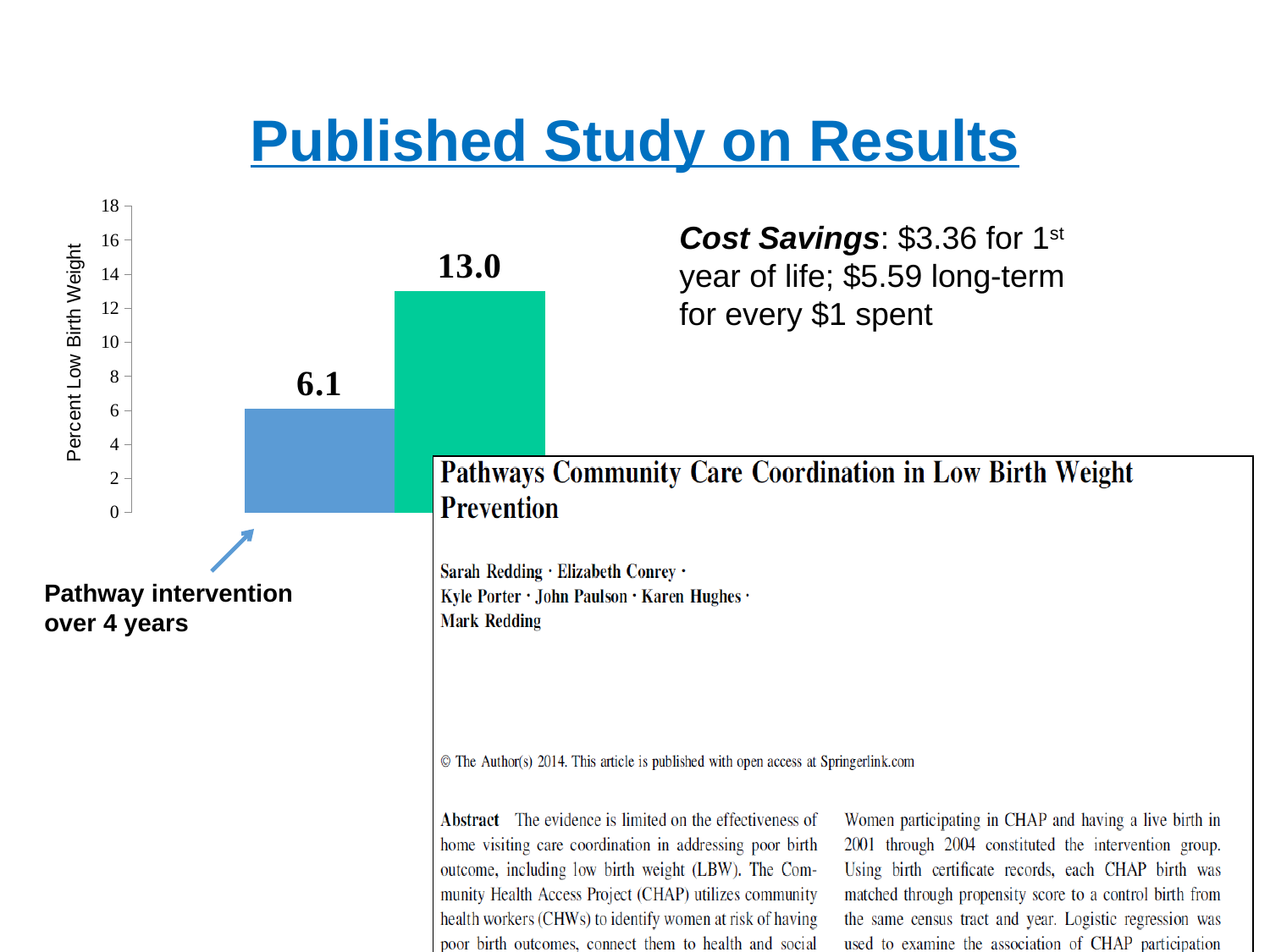
Is the value of the Pathway intervention bar greater or less than 8? less What is the value of the blue bar labelled "Pathway intervention over 4 years"? 6.1 What is the maximum value shown on the vertical axis of the chart? 18 What is the label on the vertical axis of the chart? Percent Low Birth Weight What is the value of the green bar in the chart? 13.0 Is the value of the green bar greater or less than 12? greater What is the lowest value shown in the chart? 6.1 What is the highest value shown in the chart? 13.0 How many bars are plotted in the chart? 2 What kind of chart is shown on the slide? bar chart What is the difference between the green bar (13.0) and the blue bar (6.1)? 6.9 Which bar has the higher value, the blue bar or the green bar? the green bar